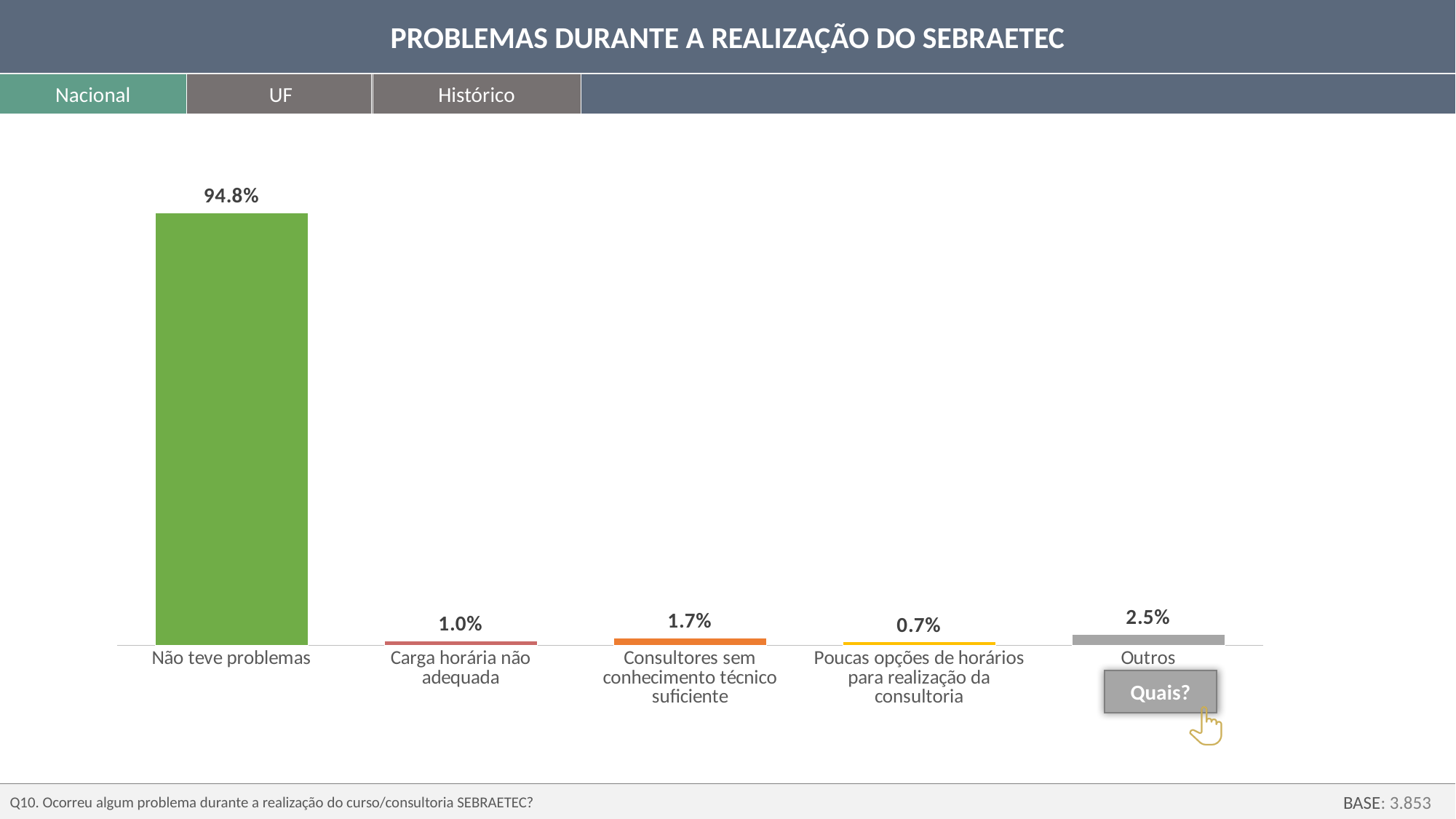
What is the value for "Consultores sem conhecimento técnico suficiente"? 1.7% What is the value for "Carga horária não adequada"? 1.0% What is the value for "Não teve problemas"? 94.8% What kind of chart is shown on the slide? Bar chart How many categories are shown in the chart? 5 Which category has the highest value? Não teve problemas What is the value for "Outros"? 2.5% Which category has the lowest value? Poucas opções de horários para realização da consultoria Which is larger, the value for "Consultores sem conhecimento técnico suficiente" or the value for "Outros"? Outros What is the value for "Poucas opções de horários para realização da consultoria"? 0.7% What is the title of the chart? PROBLEMAS DURANTE A REALIZAÇÃO DO SEBRAETEC What is the difference between the values for "Outros" and "Carga horária não adequada"? 1.5%